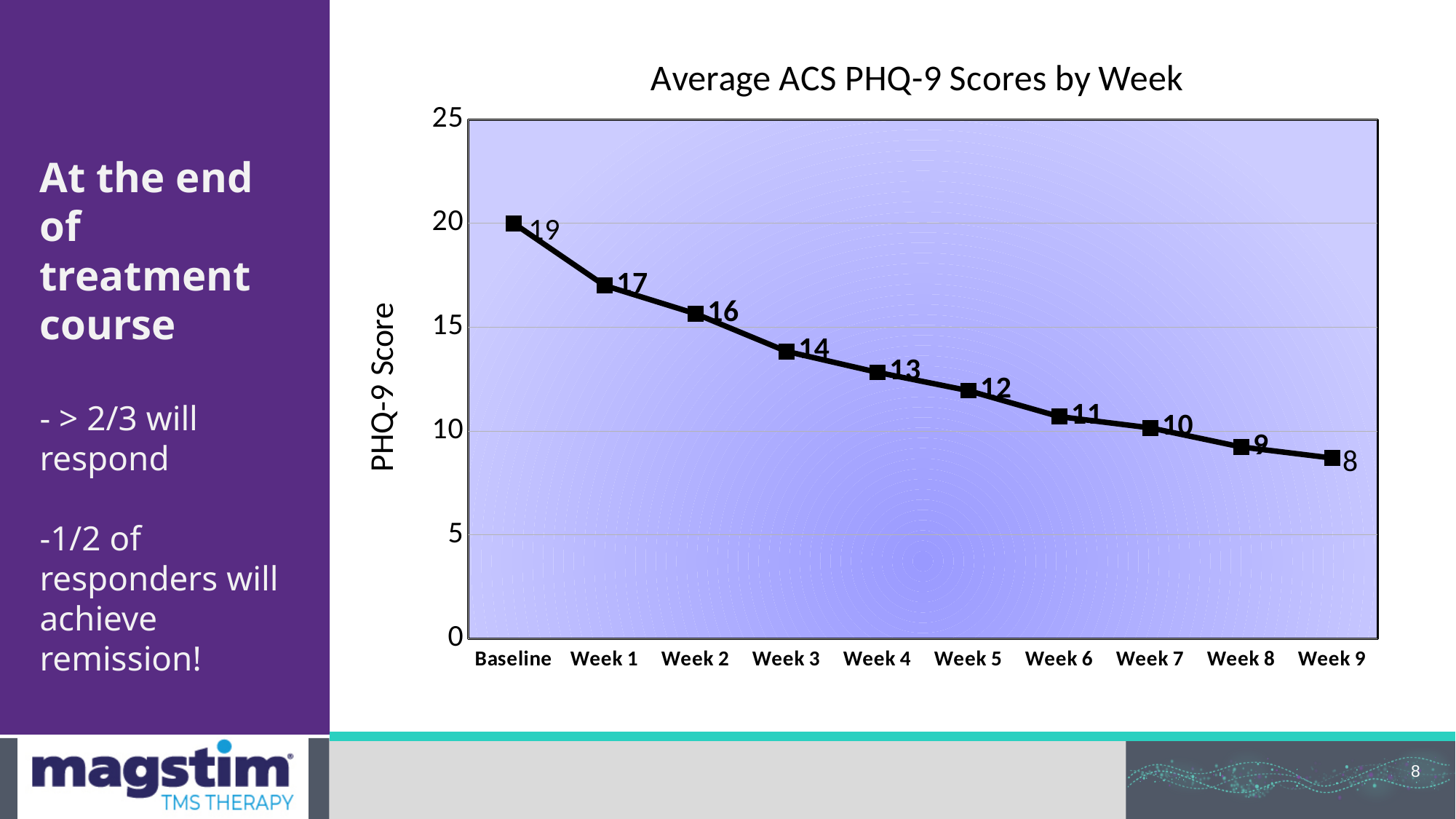
How many time points are plotted on the chart? 10 What is the difference between the Week 1 score and the Week 3 score? 3 Which is larger, the score at Week 2 or the score at Week 6? Week 2 Do the PHQ-9 scores rise or fall from Baseline to Week 9? Fall Is the value for Week 7 greater or less than 15? less Which week has the lowest average PHQ-9 score? Week 9 What is the average PHQ-9 score at Week 9? 8 Which week has the highest average PHQ-9 score? Baseline What kind of chart is shown on the slide? Line chart What is the average PHQ-9 score at Baseline? 19 What is the difference between the Baseline score and the Week 9 score? 11 What is the average PHQ-9 score at Week 5? 12